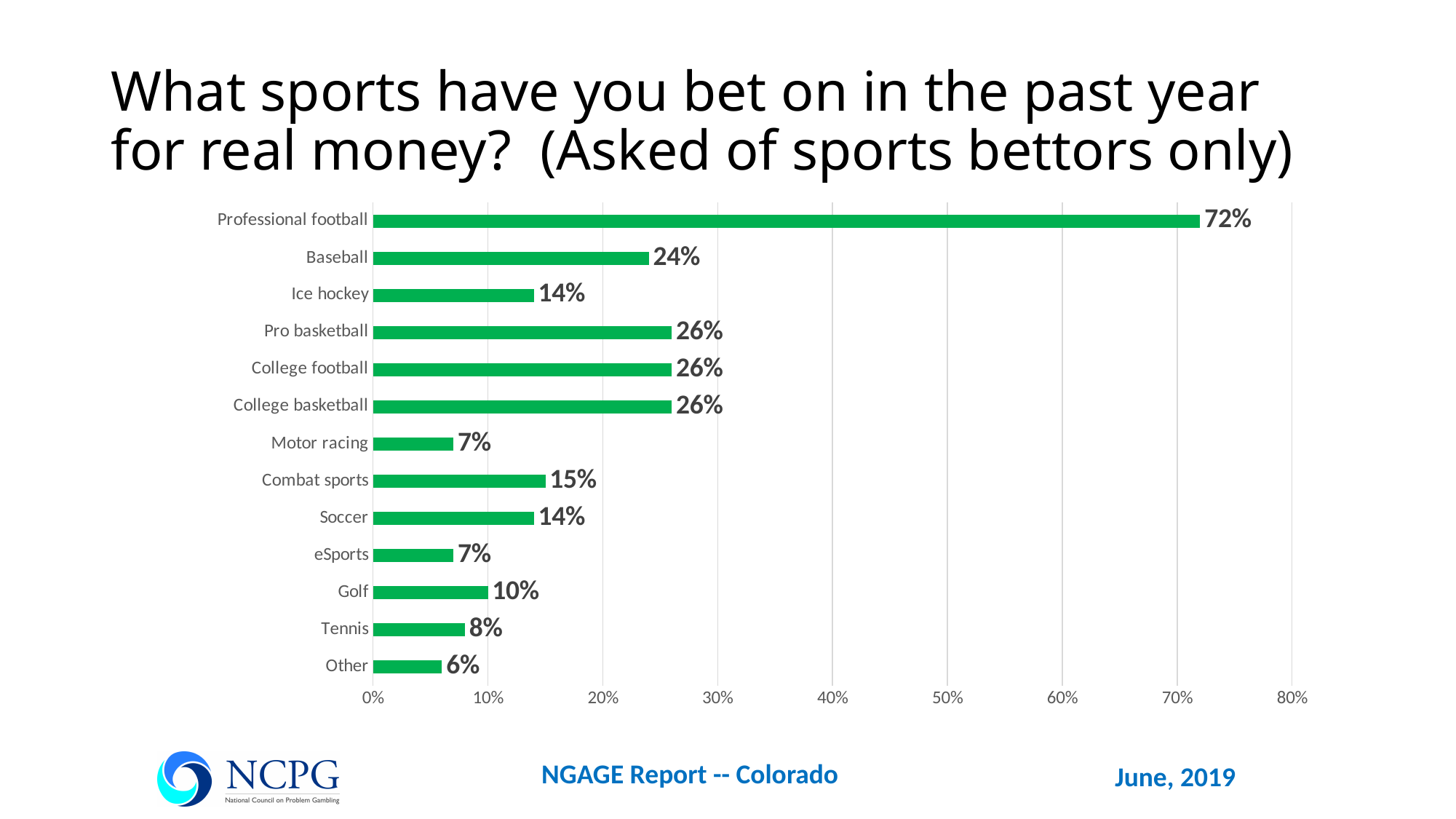
What is the value shown for Combat sports? 15% What is the difference between the values for Tennis and Other? 2% Is the value for Pro basketball greater or less than 20%? greater What percentage of sports bettors bet on Professional football? 72% Which category has the lowest value on the chart? Other What is the difference between the values for Professional football and Baseball? 48% How many sport categories are shown on the chart? 13 What is the highest value shown on the x axis? 80% What is the value shown for Golf? 10% What kind of chart is shown on the slide? Bar chart Which sport has the highest percentage of bettors? Professional football Which is larger, the value for Baseball or the value for Ice hockey? Baseball